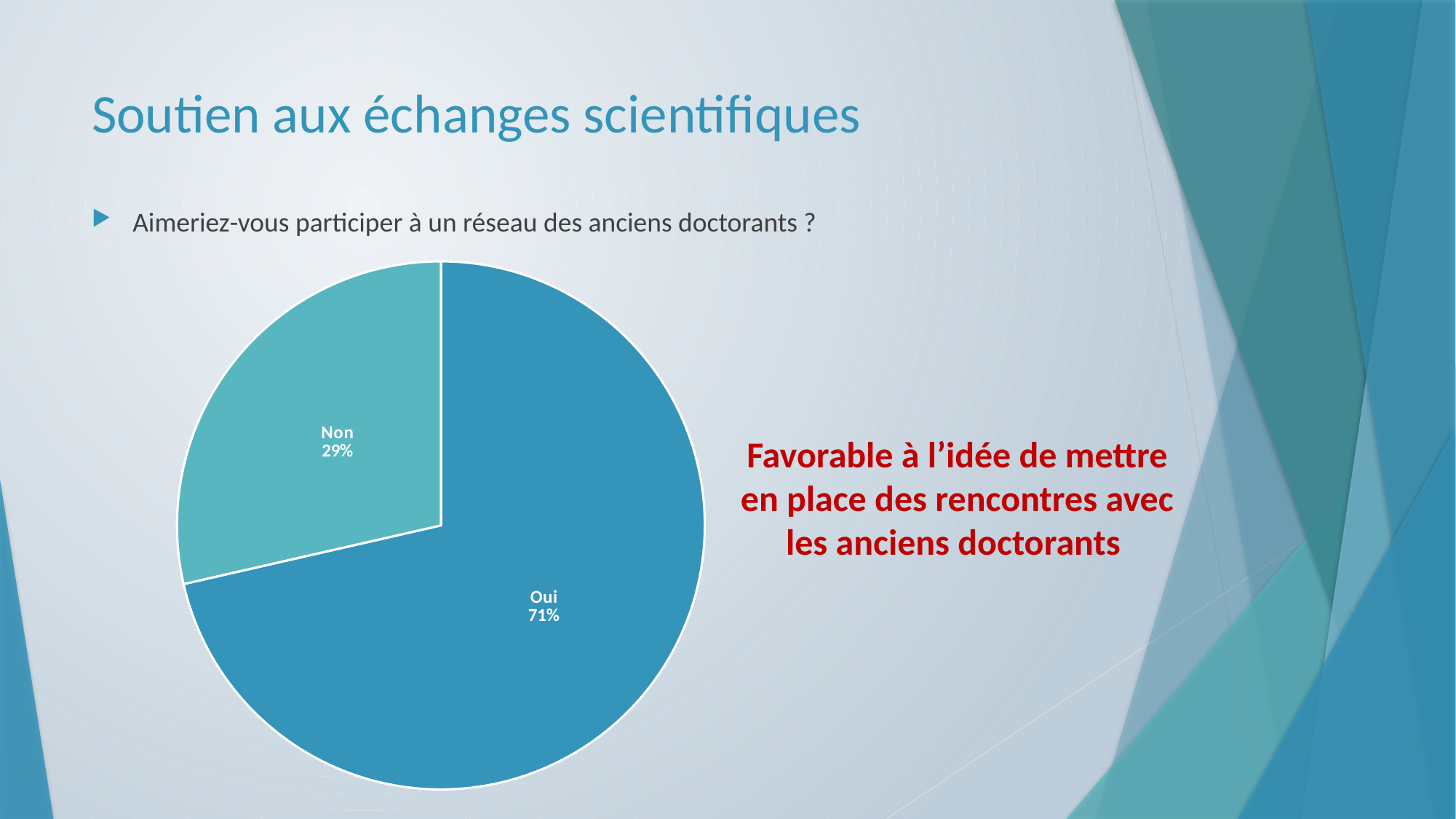
Which slice of the pie is drawn in the lighter teal colour? Non What share of the pie does the "Non" slice represent? 29% Which slice of the pie is the smallest? Non What kind of chart is shown on the slide? pie chart What survey question does the pie chart answer, as written above it? Aimeriez-vous participer à un réseau des anciens doctorants ? What share of the pie does the "Oui" slice represent? 71% Which slice of the pie is the largest? Oui Which is larger, the "Oui" slice or the "Non" slice? Oui What is the total of the two slices shown in the pie chart? 100% What is the difference in percentage points between the "Oui" and "Non" slices? 42 How many slices does the pie chart have? 2